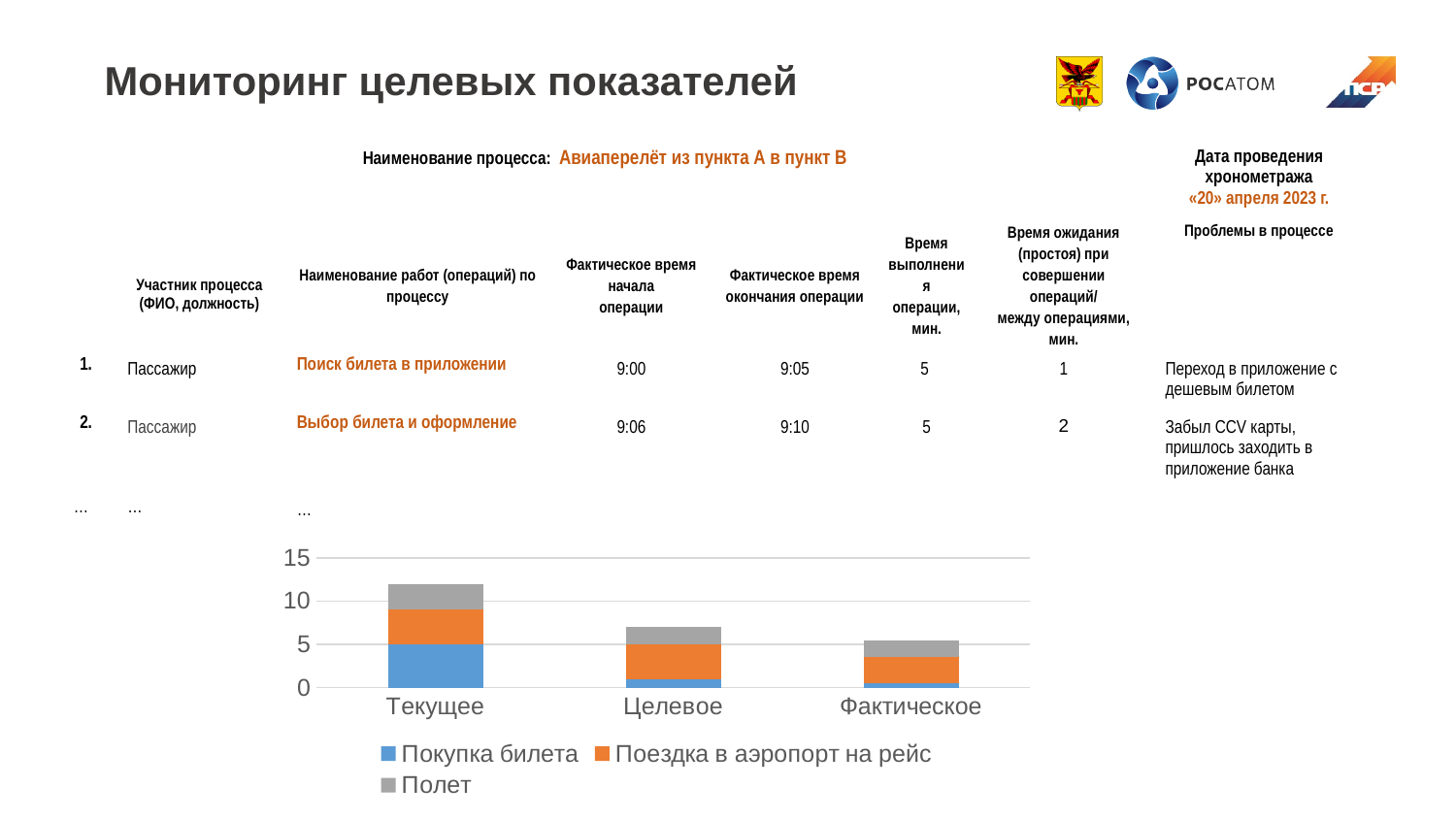
Is the total of the stacked bar for Целевое greater or less than 10? less Which colour represents the Полет series in the chart? Gray Do the stacked bar totals rise or fall from left to right across the x axis? Fall How many categories are shown on the x axis of the chart? 3 Is the total of the stacked bar for Фактическое greater or less than 10? less Is the total of the stacked bar for Текущее greater or less than 10? greater Which category has the tallest stacked bar in the chart? Текущее Which category has the shortest stacked bar in the chart? Фактическое Which category has the larger Покупка билета segment, Текущее or Целевое? Текущее Which stacked bar is taller, Текущее or Целевое? Текущее How many series does the chart legend list? 3 What kind of chart is shown on the slide? Stacked bar chart